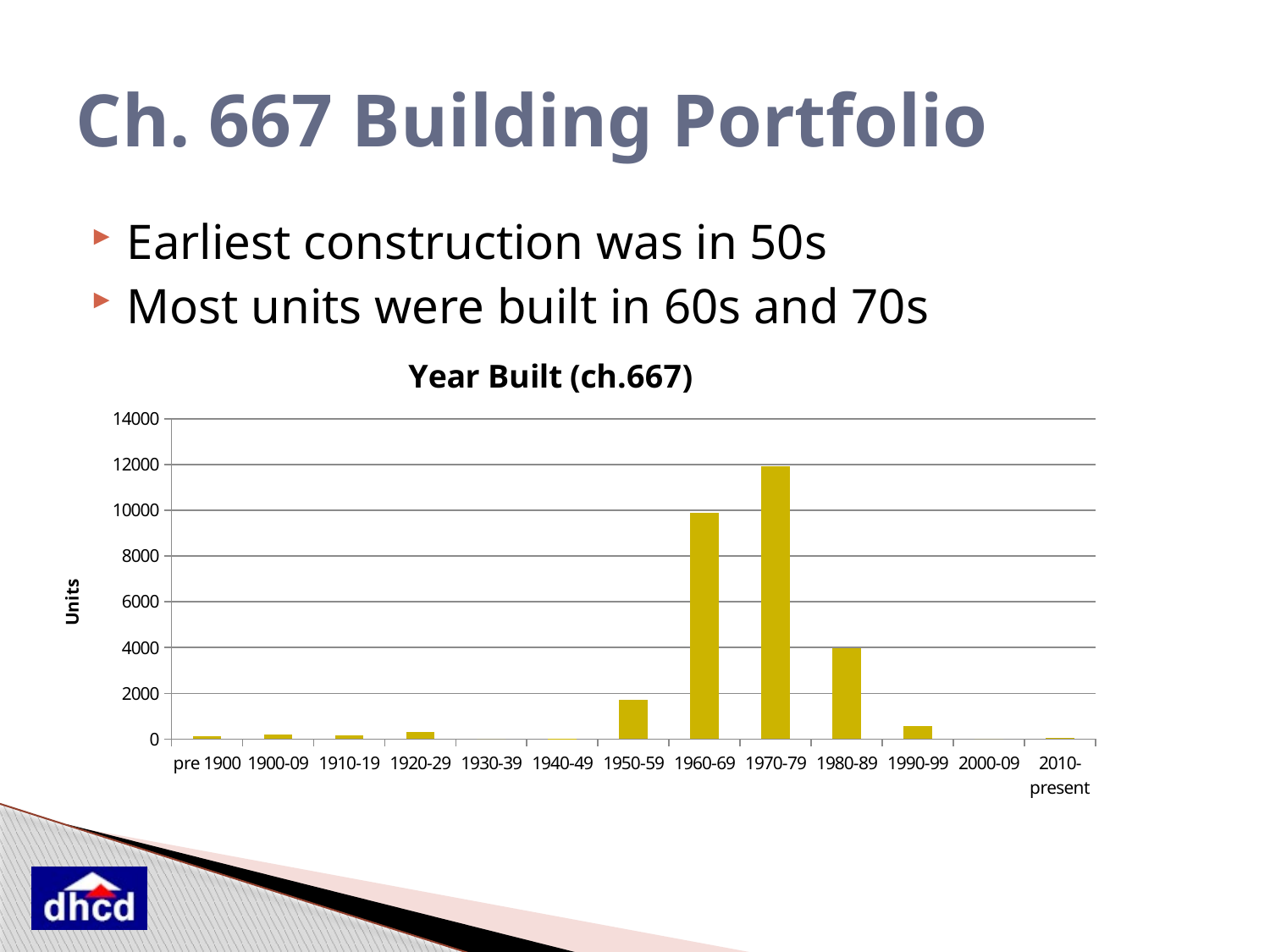
Which has more units, 1950-59 or 1990-99? 1950-59 Is the value for 1990-99 greater or less than 2000? less Is the value for 1950-59 greater or less than 2000? less What is the label on the vertical axis of the chart? Units Is the value for 1970-79 greater or less than 10000? greater How many year-built categories are shown on the x axis? 13 What is the title of the chart? Year Built (ch.667) Do the values rise or fall from 1970-79 to 2010-present? fall Which year-built category has the highest number of units? 1970-79 What kind of chart is shown on the slide? bar chart Which has more units, 1960-69 or 1980-89? 1960-69